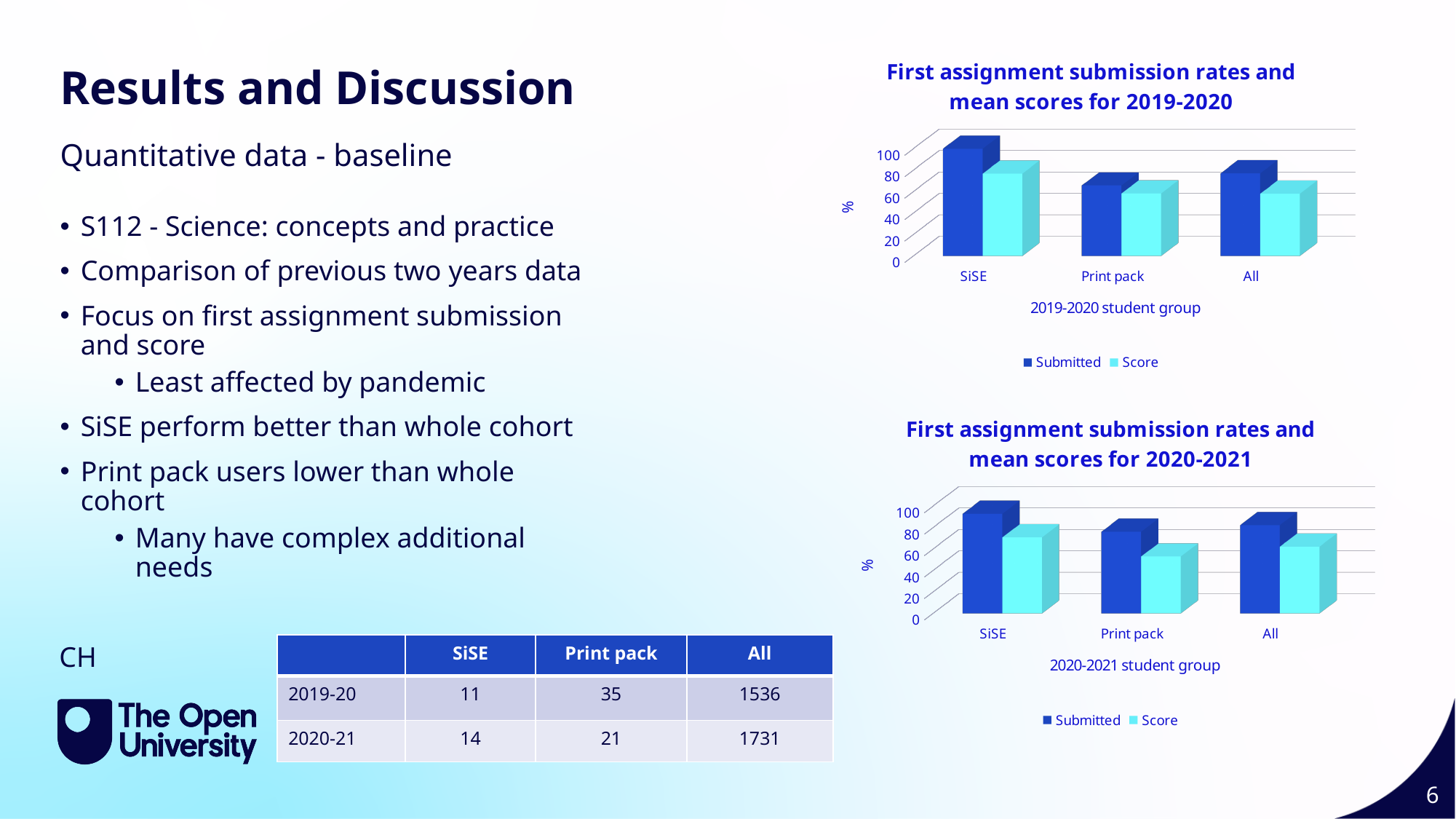
How many series does the legend of the 'First assignment submission rates and mean scores for 2020-2021' chart list? 2 In the 'First assignment submission rates and mean scores for 2020-2021' chart, which is larger: the Submitted value for SiSE or the Submitted value for Print pack? SiSE In the 'First assignment submission rates and mean scores for 2019-2020' chart, which student group has the highest Submitted value? SiSE In the 'First assignment submission rates and mean scores for 2019-2020' chart, which student group has the lowest Submitted value? Print pack What kind of chart is the 'First assignment submission rates and mean scores for 2019-2020' chart? bar chart In the 'First assignment submission rates and mean scores for 2019-2020' chart, is the Submitted value for SiSE greater or less than 80? greater What is the x-axis title of the 'First assignment submission rates and mean scores for 2020-2021' chart? 2020-2021 student group What are the two legend entries in the 'First assignment submission rates and mean scores for 2019-2020' chart? Submitted, Score In the 'First assignment submission rates and mean scores for 2019-2020' chart, is the Score value for Print pack greater or less than 80? less In the 'First assignment submission rates and mean scores for 2020-2021' chart, which student group has the lowest Score value? Print pack In the 'First assignment submission rates and mean scores for 2020-2021' chart, is the Score value for Print pack greater or less than 40? greater How many student group categories are shown on the x axis of the 'First assignment submission rates and mean scores for 2019-2020' chart? 3